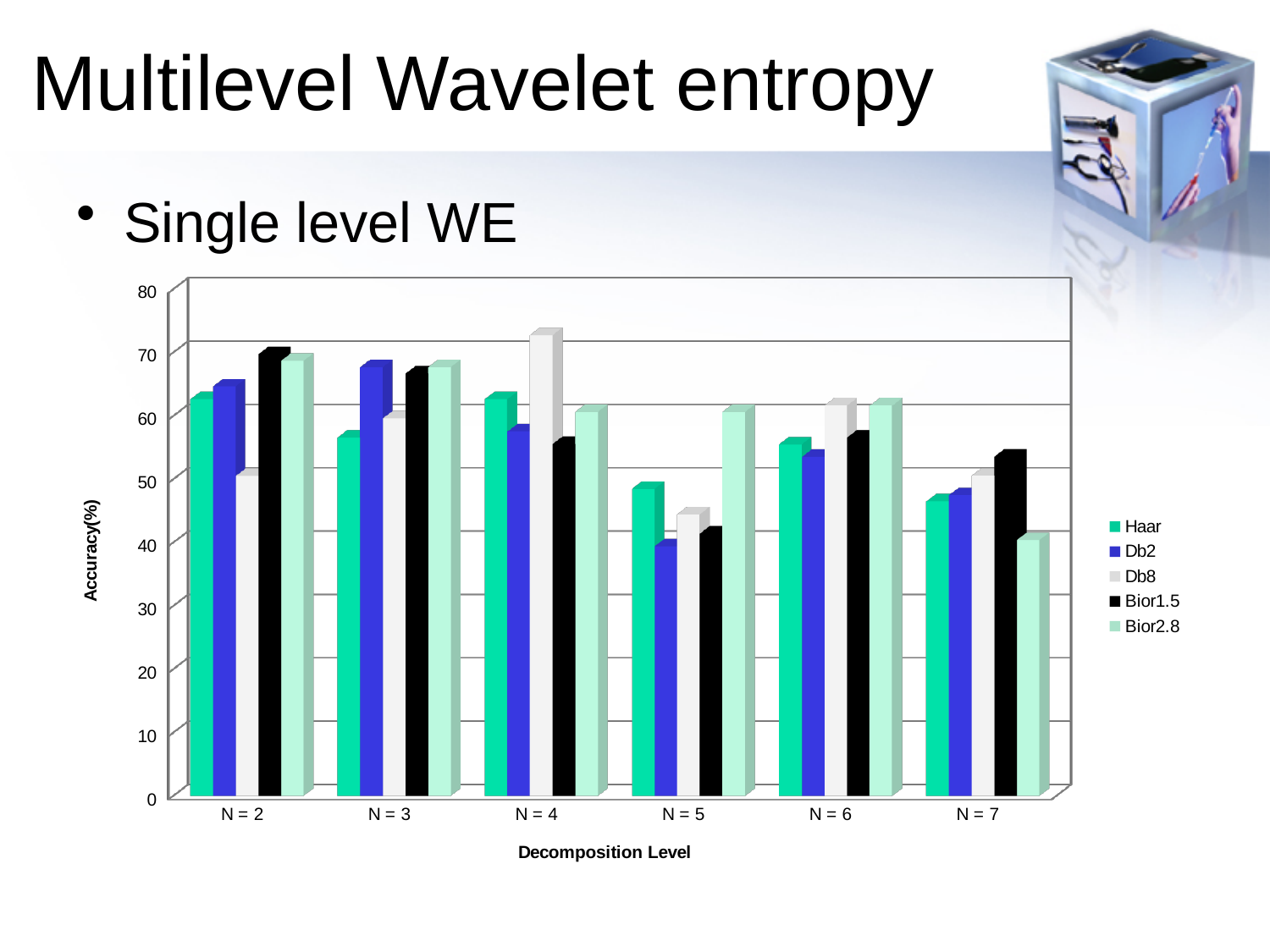
What is the label of the x axis? Decomposition Level Is the Db8 accuracy larger at N = 4 or at N = 5? N = 4 What is the label of the y axis? Accuracy(%) What kind of chart is shown on the slide? bar chart Is the value for Haar at N = 5 greater or less than 50? less Is the value for Db2 at N = 3 greater or less than 60? greater Which series has the lowest accuracy at N = 7? Bior2.8 How many decomposition levels are shown on the x axis? 6 Is the value for Bior1.5 at N = 5 greater or less than 50? less How many series does the legend list? 5 Which series has the highest accuracy at N = 4? Db8